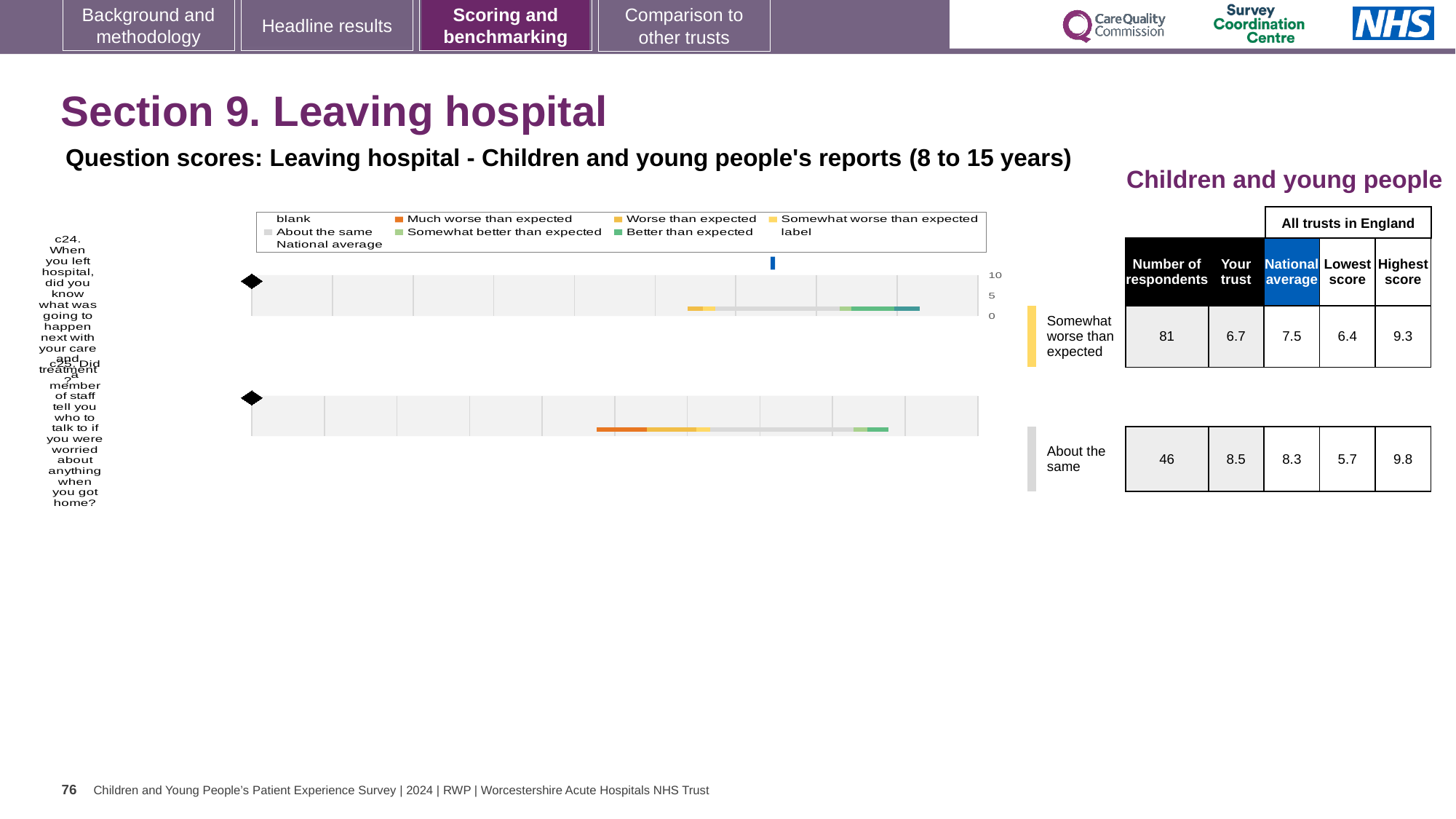
Which benchmark category is question c24 assigned to on the slide? Somewhat worse than expected How many respondents answered question c24, as shown in the table beside the chart? 81 What kind of chart is used to show the question scores on this slide? bar chart What is the difference between the highest score (9.3) and the lowest score (6.4) for question c24? 2.9 According to the table beside the chart, what is the national average score for question c24? 7.5 How many survey questions (rows) are plotted on the slide? 2 Which benchmark category is question c25 assigned to on the slide? About the same According to the table beside the chart, what is the 'Your trust' score for question c24 (When you left hospital, did you know what was going to happen next with your care and treatment?)? 6.7 What is the lowest score among all trusts in England for question c24, as shown in the table? 6.4 For question c25, which is larger: the 'Your trust' score or the national average? Your trust According to the table beside the chart, what is the 'Your trust' score for question c25 (Did a member of staff tell you who to talk to if you were worried about anything when you got home?)? 8.5 What is the highest score among all trusts in England for question c25, as shown in the table? 9.8